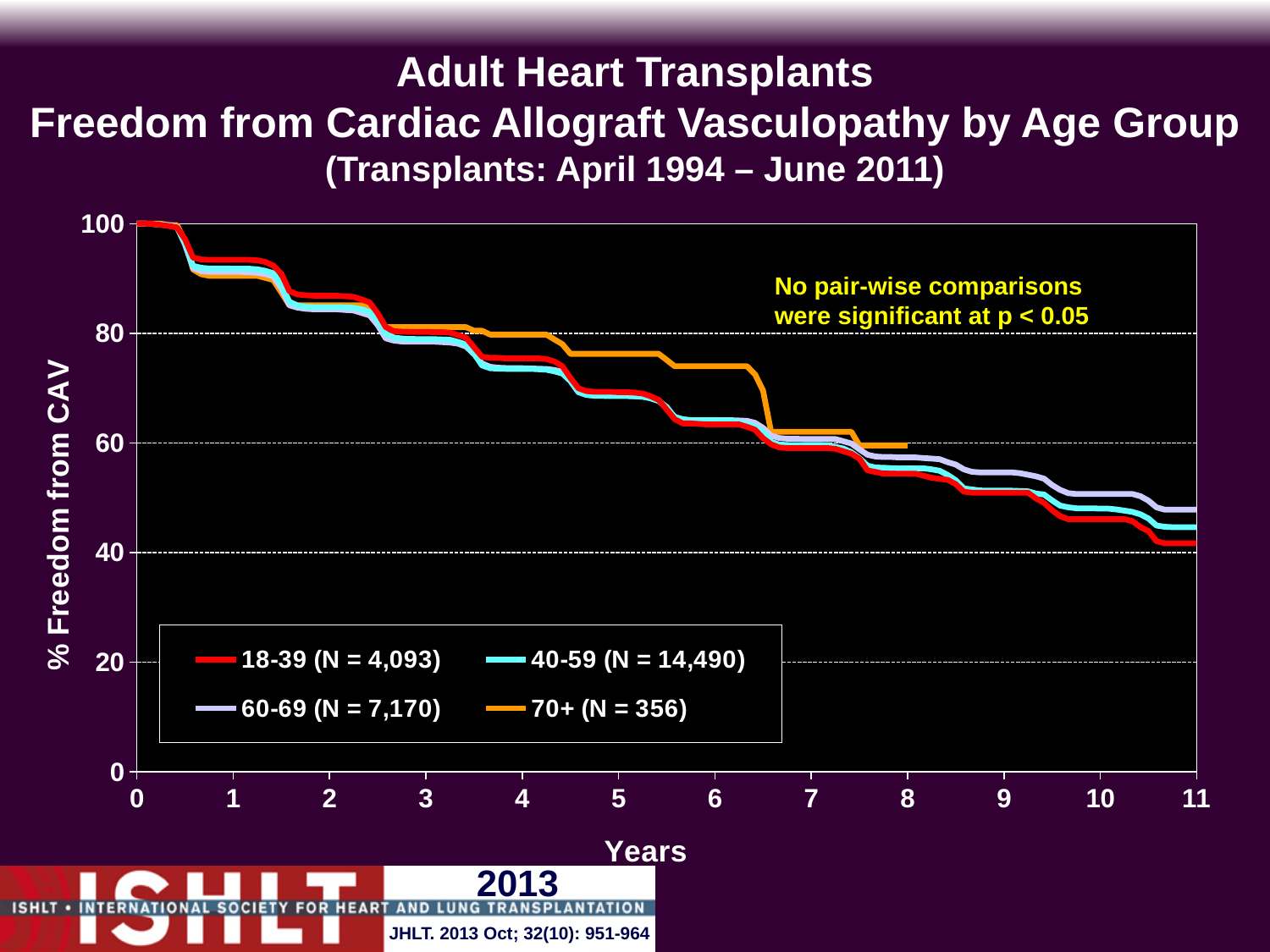
Do the values for the 40-59 group rise or fall as years increase? fall How many series does the legend list? 4 Is the value for the 70+ group at year 6 greater or less than 60? greater Which age group has the highest % freedom from CAV at year 11? 60-69 Which age group has the lowest % freedom from CAV at year 11? 18-39 At year 6, which is larger: the value for the 70+ group or the value for the 18-39 group? 70+ What kind of chart is shown on the slide? line chart Is the value for the 60-69 group at year 11 greater or less than 60? less Which age group has the highest % freedom from CAV at year 6? 70+ Is the value for the 40-59 group at year 2 greater or less than 80? greater What is the % freedom from CAV for the 18-39 group at year 0? 100 According to the legend, what is N for the 40-59 age group? 14,490